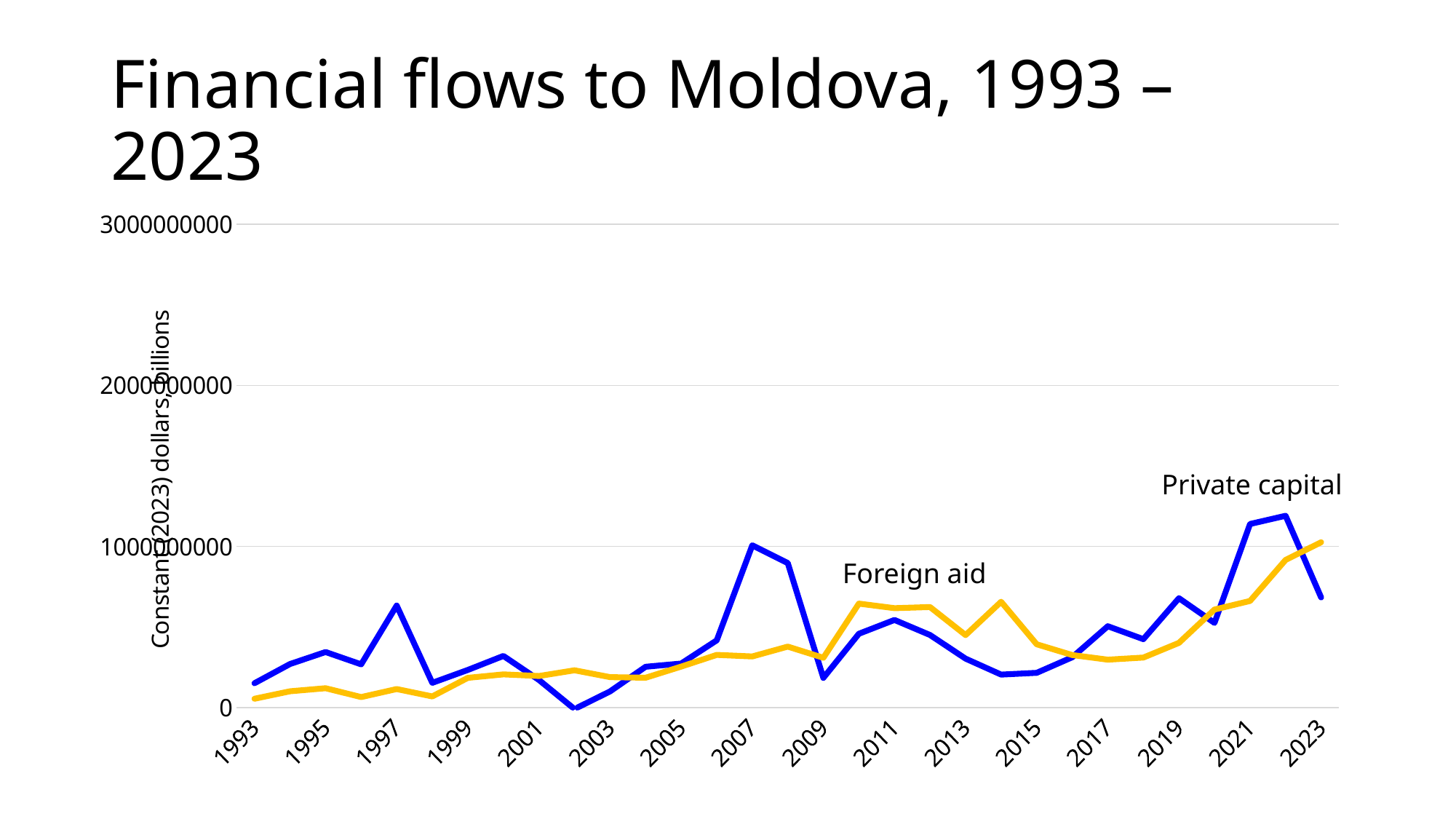
Is the value for Private capital in 2022 greater or less than 1000000000? greater What colour is the Private capital line? Blue What is the title of the chart on the slide? Financial flows to Moldova, 1993 – 2023 Is the value for Private capital in 2002 greater or less than 1000000000? less In 2010, which series has the larger value, Private capital or Foreign aid? Foreign aid In 1997, which series has the larger value, Private capital or Foreign aid? Private capital Does the Foreign aid line rise or fall from 2017 to 2023? Rise What kind of chart is shown on the slide? Line chart In which year is the Private capital line at its lowest? 2002 How many series are plotted on the chart? 2 Is the value for Foreign aid in 1993 greater or less than 1000000000? less How many year labels are shown on the x axis? 16